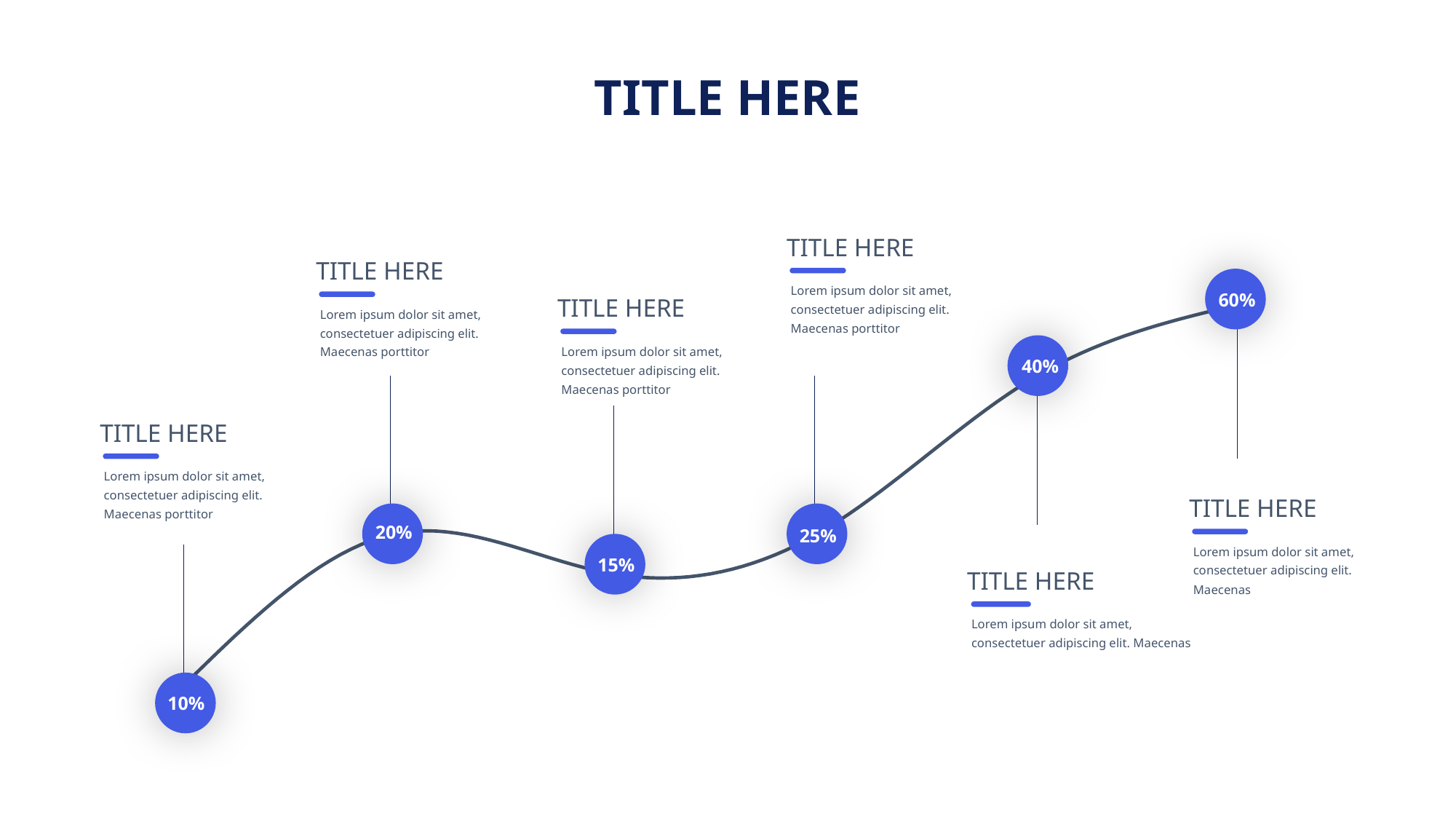
What is the value of the last (rightmost) point on the line? 60% What is the difference between the second point (20%) and the third point (15%)? 5% What is the value of the fifth point from the left on the line? 40% What kind of chart is shown on the slide? line chart What is the value of the first (leftmost) point on the line? 10% Which point has the highest value? the last (rightmost) point, 60% What is the difference between the last point (60%) and the fifth point (40%)? 20% What is the value of the third point from the left on the line? 15% How many data points are plotted on the line? 6 Which is larger, the second point or the third point on the line? the second point (20%) Which point has the lowest value? the first (leftmost) point, 10% Do the values generally rise or fall from left to right along the line? rise